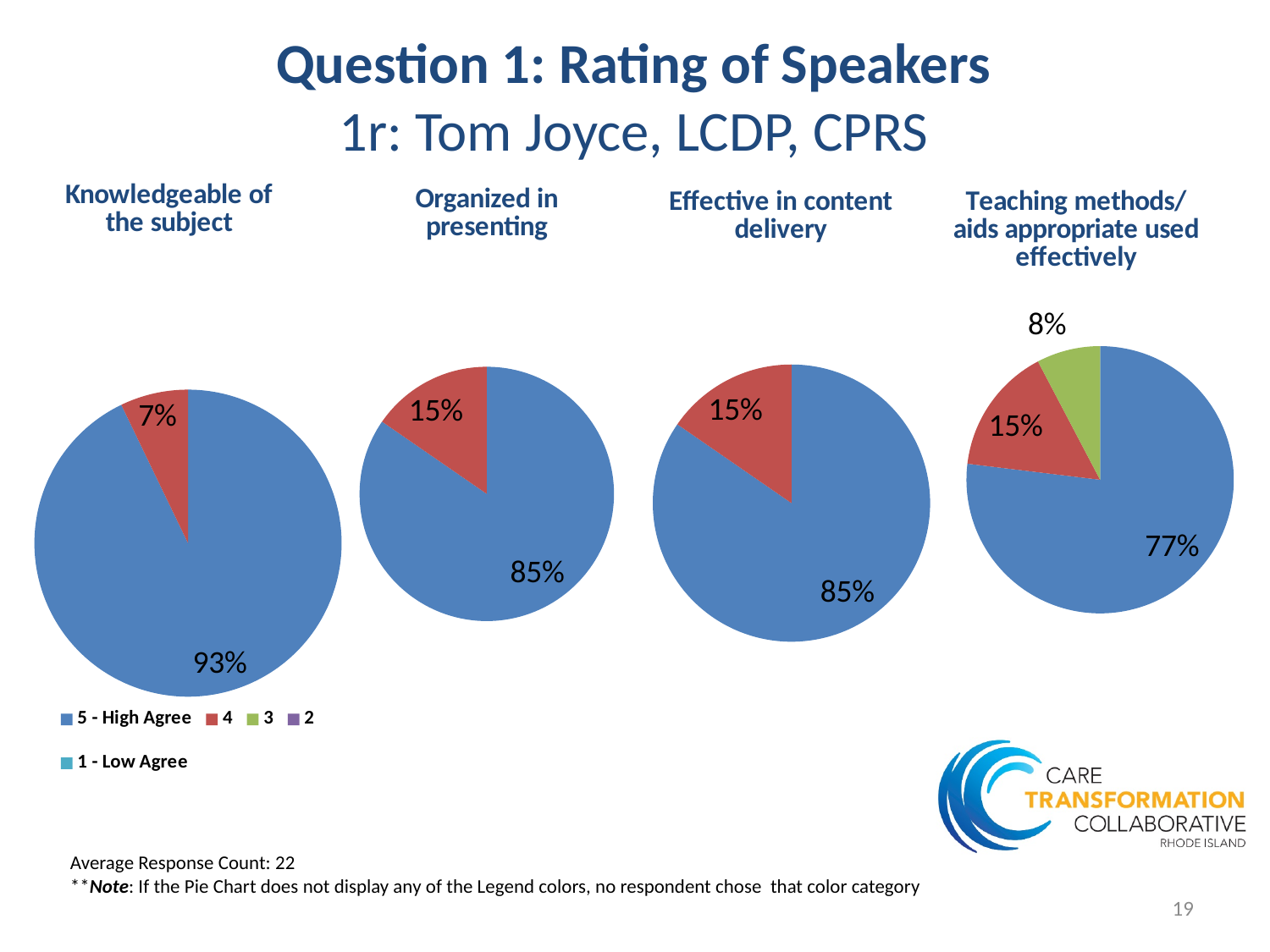
In the 'Teaching methods/aids appropriate used effectively' chart, which rating category has the largest slice? 5 - High Agree Which chart has the larger '5 - High Agree' share: 'Knowledgeable of the subject' or 'Teaching methods/aids appropriate used effectively'? Knowledgeable of the subject In the 'Organized in presenting' chart, what share of respondents chose '5 - High Agree'? 85% In the 'Effective in content delivery' chart, what share of respondents chose '4'? 15% What type of chart is used on this slide? Pie chart In the 'Teaching methods/aids appropriate used effectively' chart, which rating category has the smallest slice? 3 In the 'Knowledgeable of the subject' chart, what share of respondents chose '4'? 7% In the 'Knowledgeable of the subject' chart, what is the difference between the '5 - High Agree' share and the '4' share? 86% How many slices does the 'Teaching methods/aids appropriate used effectively' chart have? 3